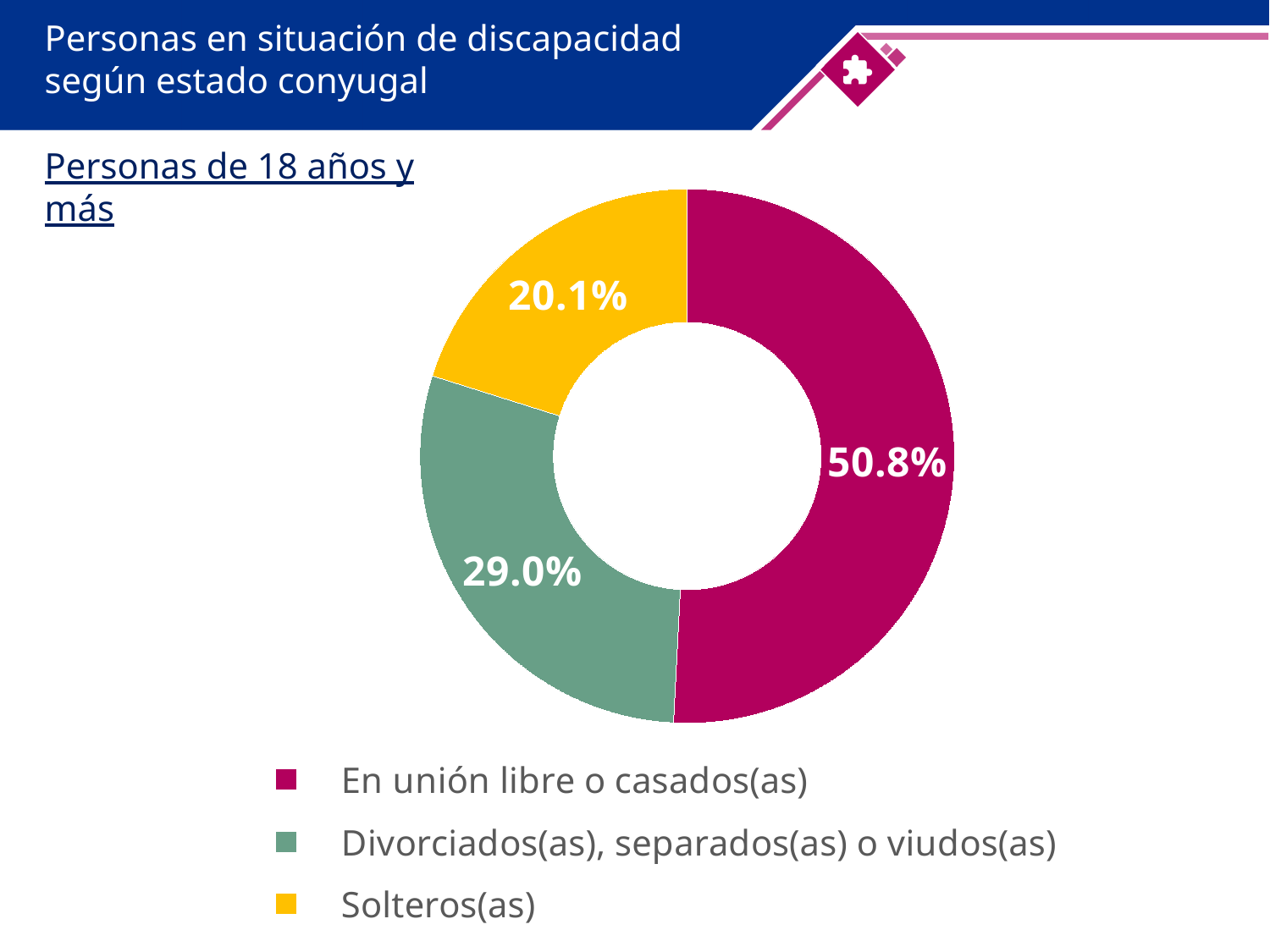
Which is larger: the share for 'Divorciados(as), separados(as) o viudos(as)' or the share for 'Solteros(as)'? Divorciados(as), separados(as) o viudos(as) What percentage of the chart corresponds to 'Solteros(as)'? 20.1% What is the title of the slide containing the chart? Personas en situación de discapacidad según estado conyugal What is the difference in percentage points between 'Divorciados(as), separados(as) o viudos(as)' and 'Solteros(as)'? 8.9 What colour is the slice for 'Solteros(as)'? Yellow What percentage of the chart corresponds to 'En unión libre o casados(as)'? 50.8% What percentage of the chart corresponds to 'Divorciados(as), separados(as) o viudos(as)'? 29.0% Which category has the largest share of the chart? En unión libre o casados(as) How many categories does the chart show? 3 What is the difference in percentage points between 'En unión libre o casados(as)' and 'Solteros(as)'? 30.7 Which category has the smallest share of the chart? Solteros(as) What kind of chart is shown on the slide? Pie chart (doughnut)